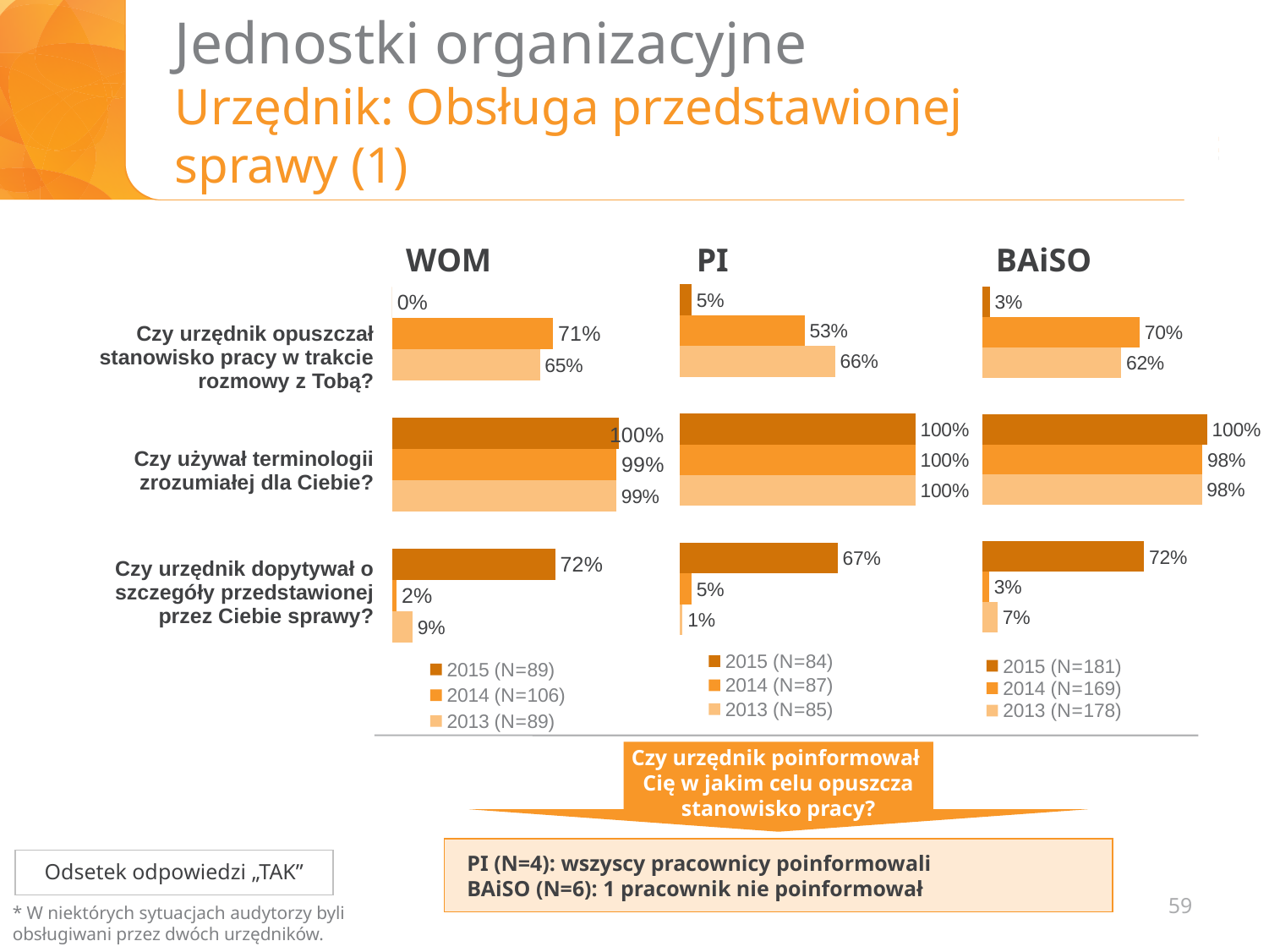
What sample size (N) is given for 2015 in the BAiSO chart legend? N=181 In the BAiSO chart, what is the 2013 value for "Czy używał terminologii zrozumiałej dla Ciebie?"? 98% How many question categories are shown in the BAiSO chart? 3 In the BAiSO chart, what is the difference between the 2014 and 2013 values for "Czy urzędnik opuszczał stanowisko pracy w trakcie rozmowy z Tobą?"? 8% How many series does the legend of the WOM chart list? 3 In the WOM chart, what is the 2014 value for "Czy urzędnik opuszczał stanowisko pracy w trakcie rozmowy z Tobą?"? 71% In the WOM chart, which year has the highest value for "Czy urzędnik dopytywał o szczegóły przedstawionej przez Ciebie sprawy?"? 2015 (N=89) In the PI chart, which is larger for "Czy urzędnik opuszczał stanowisko pracy w trakcie rozmowy z Tobą?": the 2014 value or the 2013 value? 2013 In the PI chart, which year has the lowest value for "Czy urzędnik opuszczał stanowisko pracy w trakcie rozmowy z Tobą?"? 2015 (N=84) In the PI chart, what is the 2015 value for "Czy urzędnik dopytywał o szczegóły przedstawionej przez Ciebie sprawy?"? 67% What type of chart is the PI chart? Bar chart In the WOM chart, what is the 2015 value for "Czy urzędnik opuszczał stanowisko pracy w trakcie rozmowy z Tobą?"? 0%